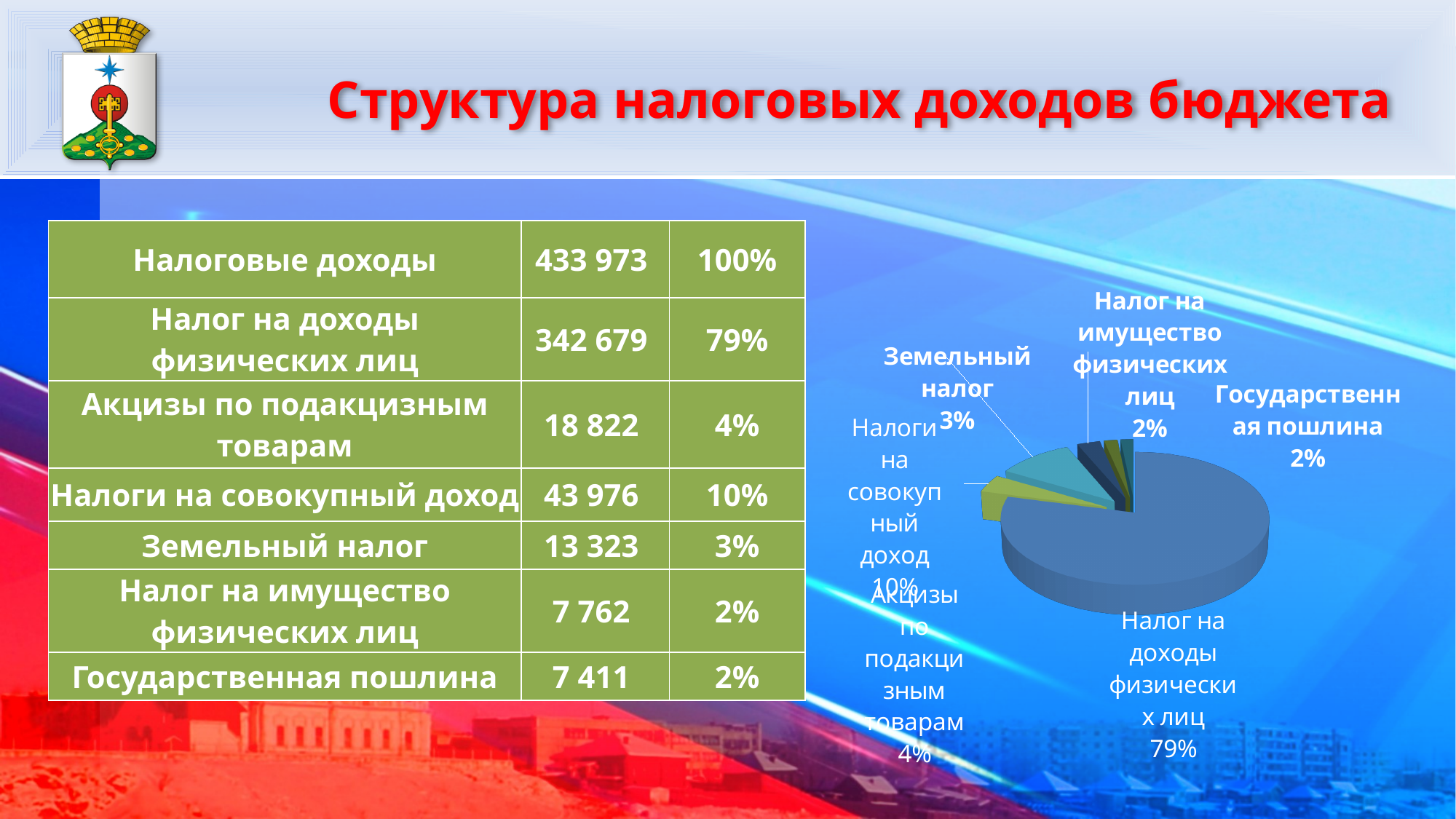
Which is larger in the pie chart: "Налоги на совокупный доход" or "Акцизы по подакцизным товарам"? Налоги на совокупный доход What share of the pie chart does "Акцизы по подакцизным товарам" have? 4% What share of the pie chart does "Налоги на совокупный доход" have? 10% What is the title of the slide containing the pie chart? Структура налоговых доходов бюджета What share of the pie chart does "Земельный налог" have? 3% What is the difference in percentage points between "Налог на доходы физических лиц" and "Налоги на совокупный доход" in the pie chart? 69 How many slices does the pie chart have? 6 What kind of chart is shown on the slide? Pie chart Which slice of the pie chart is the largest? Налог на доходы физических лиц What is the difference in percentage points between "Земельный налог" and "Налог на имущество физических лиц" in the pie chart? 1